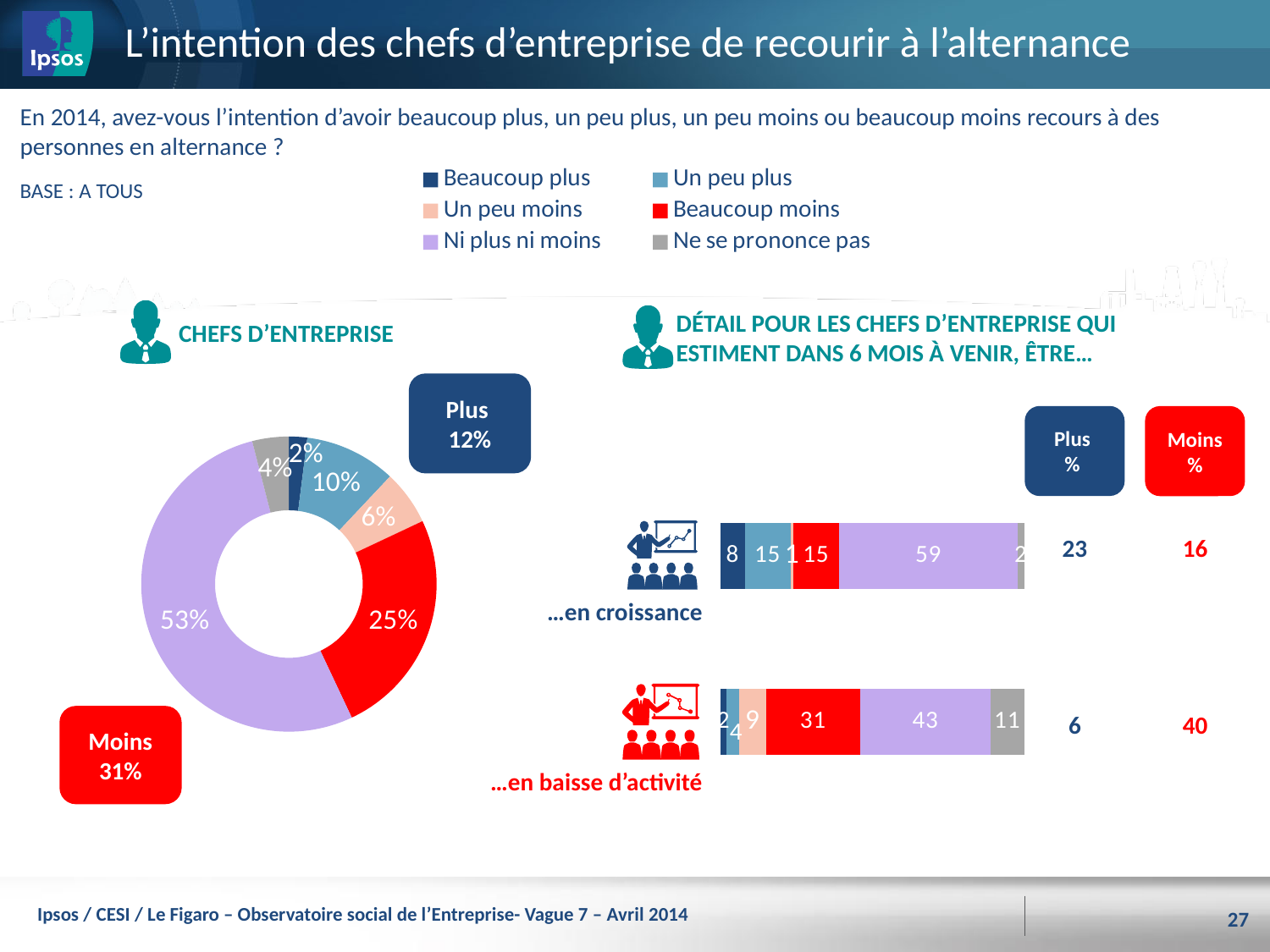
In the stacked bar chart on the right, what is the value of 'Ni plus ni moins' for '…en croissance'? 59 How many series does the legend list? 6 In the 'Chefs d'entreprise' donut chart, what share is 'Ni plus ni moins'? 53% What type of chart is the 'Chefs d'entreprise' chart on the left? Donut (pie) chart In the stacked bar chart on the right, what is the value of 'Beaucoup moins' for '…en baisse d'activité'? 31 In the stacked bar chart on the right, what is the value of 'Ne se prononce pas' for '…en baisse d'activité'? 11 In the 'Chefs d'entreprise' donut chart, which category has the largest share? Ni plus ni moins In the stacked bar chart on the right, which bar has the larger 'Beaucoup plus' value, '…en croissance' or '…en baisse d'activité'? …en croissance In the 'Chefs d'entreprise' donut chart, which category has the smallest share? Beaucoup plus In the 'Chefs d'entreprise' donut chart, what is the difference between 'Un peu plus' and 'Un peu moins'? 4 points In the 'Chefs d'entreprise' donut chart, what share is 'Beaucoup moins'? 25% In the stacked bar chart on the right, how many bars (categories) are shown? 2